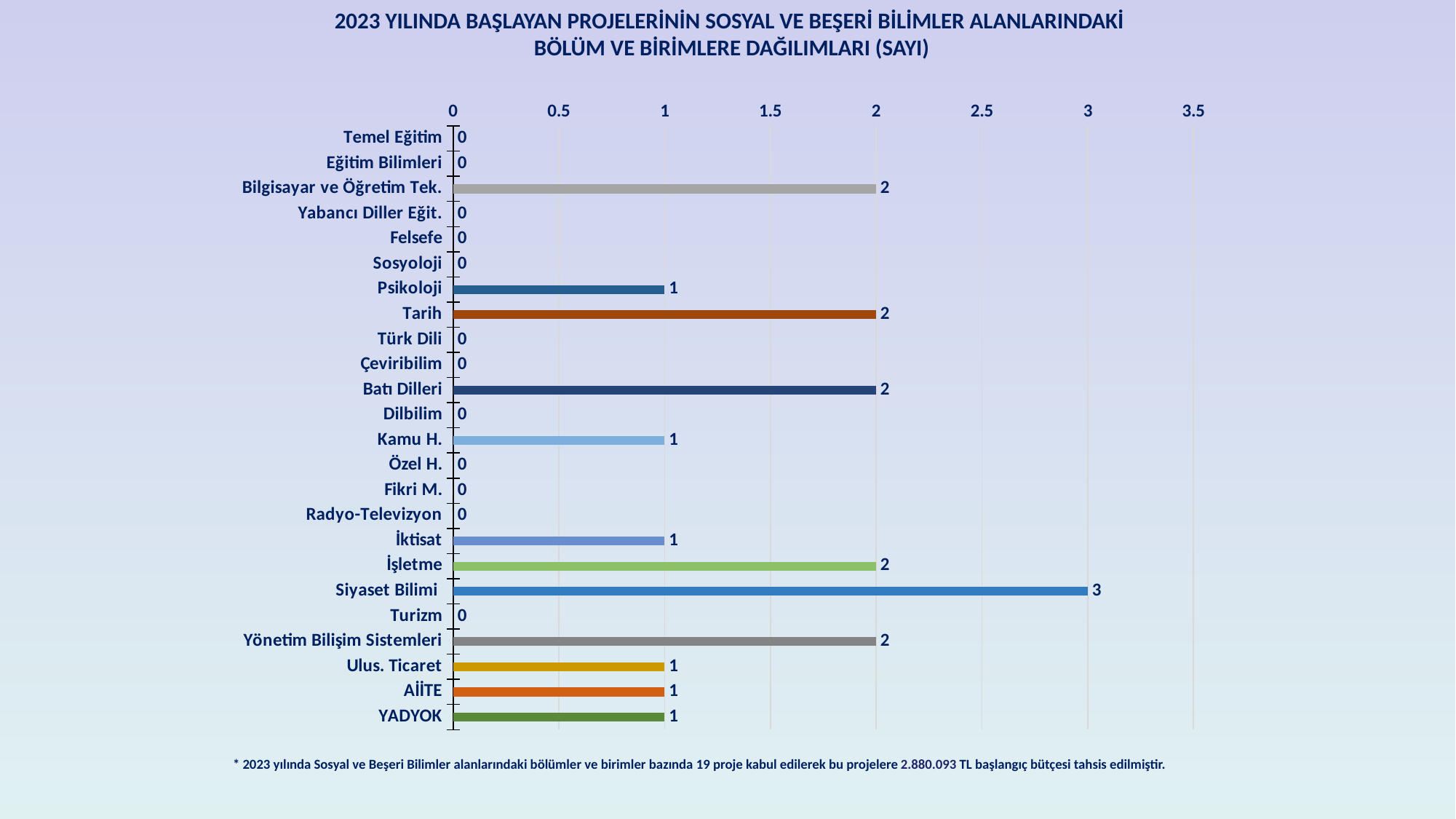
What is the value for Yönetim Bilişim Sistemleri? 2 What is the value for Siyaset Bilimi? 3 What is the highest value shown on the x axis? 3.5 What is the value for Bilgisayar ve Öğretim Tek.? 2 How many categories are shown on the chart? 24 Which is larger, the value for İşletme or the value for İktisat? İşletme What kind of chart is shown on the slide? bar chart Which category has the highest value? Siyaset Bilimi What is the difference between the values for Siyaset Bilimi and Tarih? 1 Is the value for Siyaset Bilimi greater or less than 2.5? greater What is the value for Psikoloji? 1 What is the value for Turizm? 0